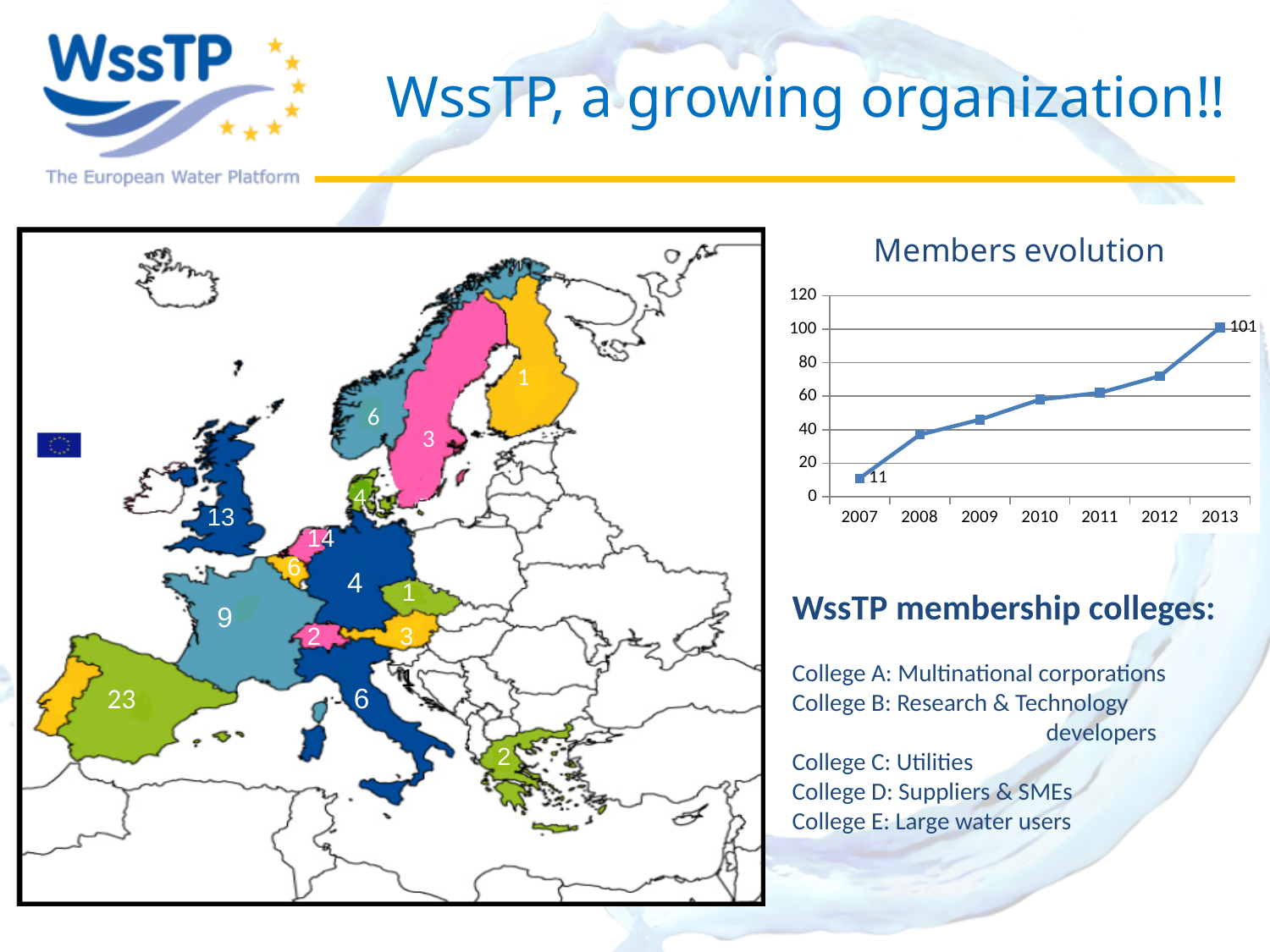
In the Members evolution chart, do the values rise or fall from 2007 to 2013? rise What kind of chart is the Members evolution chart? line chart In the Members evolution chart, which is larger, the value for 2012 or the value for 2009? 2012 In the Members evolution chart, which year has the highest value? 2013 In the Members evolution chart, what is the difference between the 2013 value and the 2007 value? 90 What is the title of the chart on the right of the slide? Members evolution In the Members evolution chart, what is the value for 2013? 101 In the Members evolution chart, which year has the lowest value? 2007 In the Members evolution chart, is the value for 2012 greater or less than 60? greater In the Members evolution chart, what is the value for 2007? 11 In the Members evolution chart, is the value for 2009 greater or less than 60? less How many years are plotted on the x axis of the Members evolution chart? 7